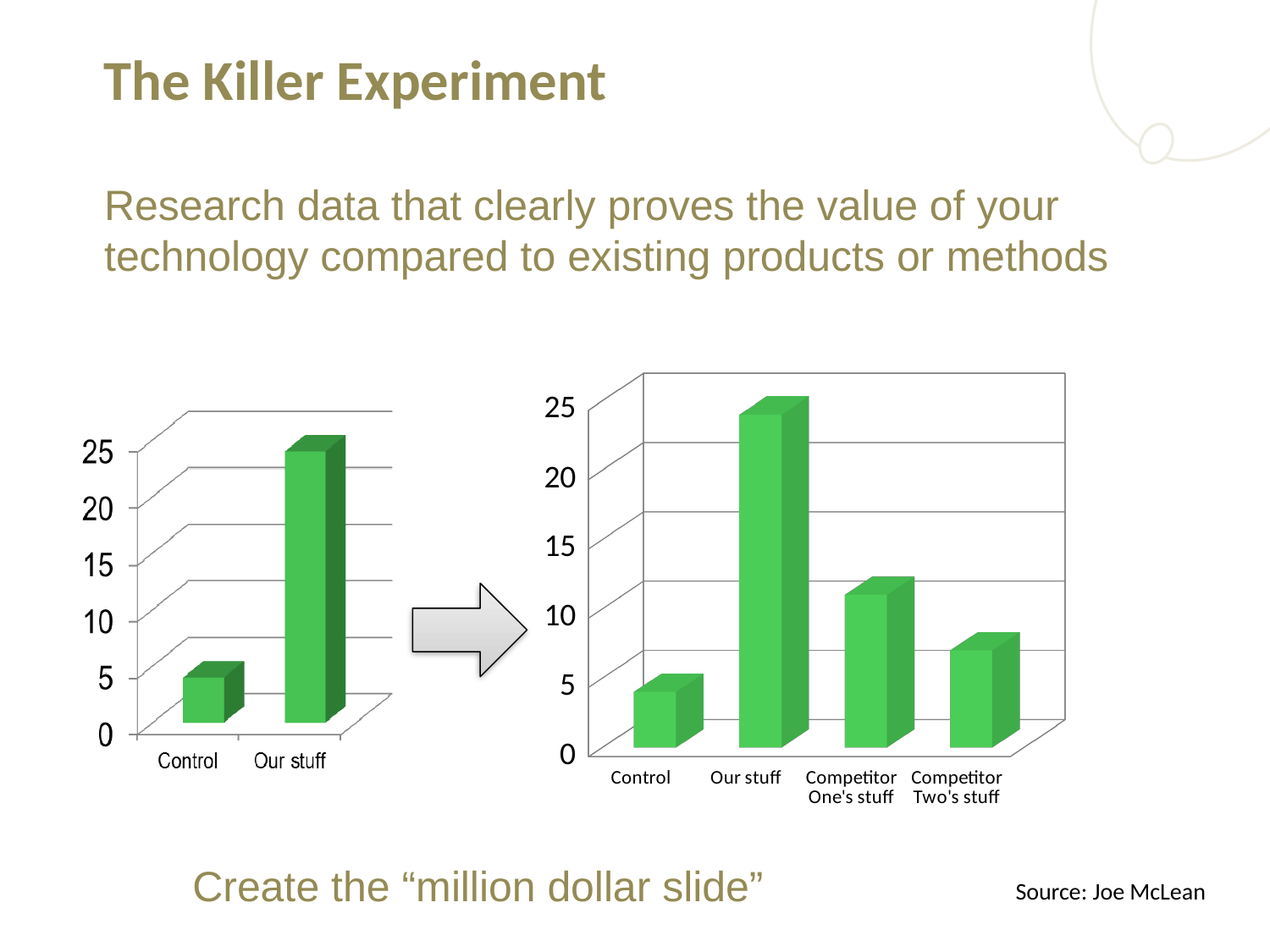
How many categories does the chart on the left of the slide show? 2 In the chart on the left of the slide, which category has the higher value? Our stuff In the chart on the right of the slide, which is larger, the value for Competitor One's stuff or the value for Competitor Two's stuff? Competitor One's stuff What kind of chart is the chart on the right of the slide? bar chart In the chart on the right of the slide, which category has the lowest value? Control How many categories does the chart on the right of the slide show? 4 In the chart on the right of the slide, is the value for Competitor One's stuff greater or less than 15? less In the chart on the right of the slide, is the value for Our stuff greater or less than 20? greater In the chart on the right of the slide, is the value for Competitor Two's stuff greater or less than 10? less In the chart on the right of the slide, which category has the highest value? Our stuff